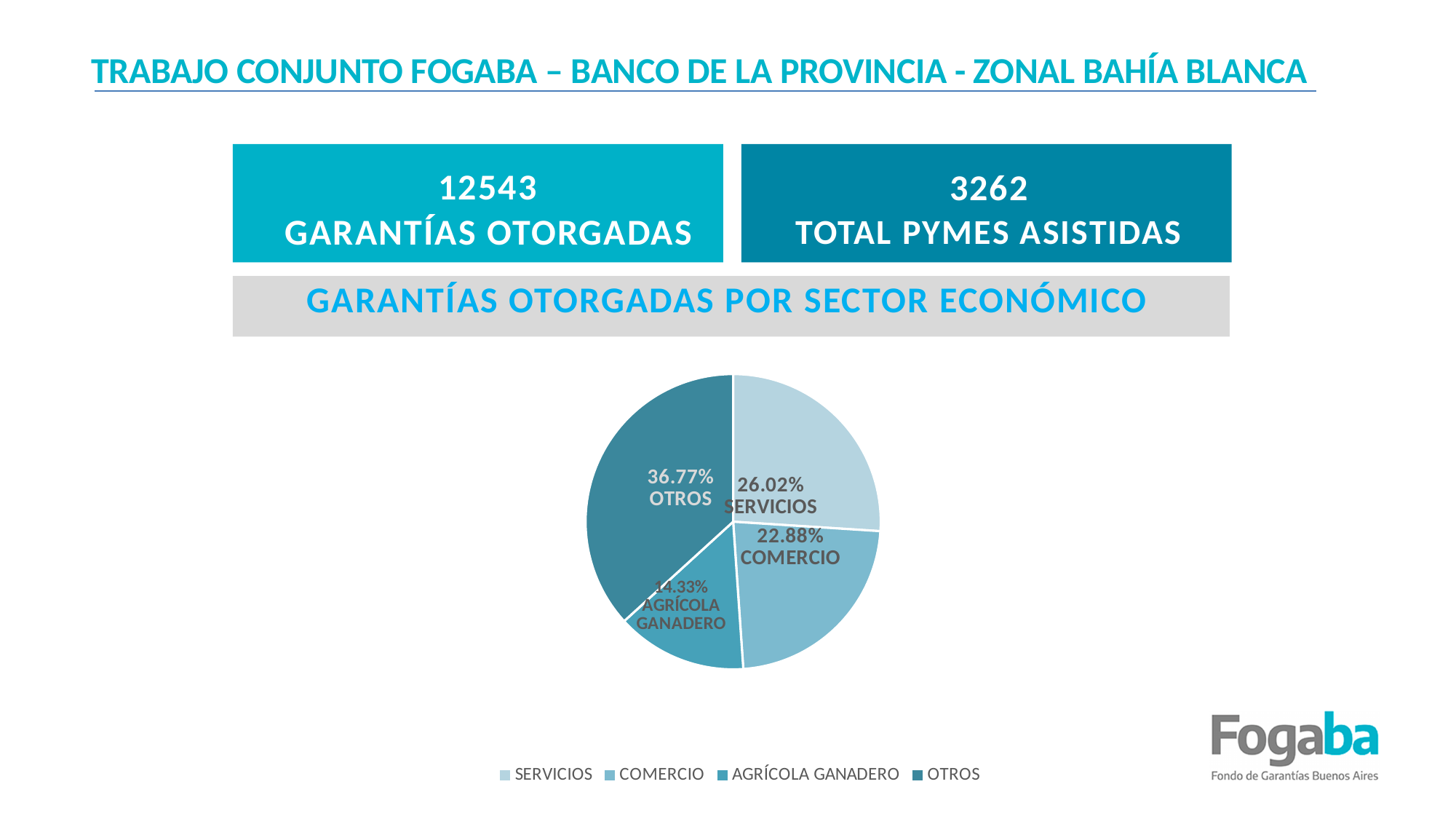
What share of the pie does OTROS represent? 36.77% How many slices does the pie chart have? 4 Which is larger, the share for SERVICIOS or the share for COMERCIO? SERVICIOS What share of the pie does COMERCIO represent? 22.88% Which sector has the largest slice of the pie? OTROS Which sector has the smallest slice of the pie? AGRÍCOLA GANADERO What kind of chart is shown on the slide? Pie chart What is the title shown above the pie chart? GARANTÍAS OTORGADAS POR SECTOR ECONÓMICO What is the difference in percentage points between OTROS and SERVICIOS? 10.75 What share of the pie does SERVICIOS represent? 26.02% What share of the pie does AGRÍCOLA GANADERO represent? 14.33% How many entries does the legend list? 4